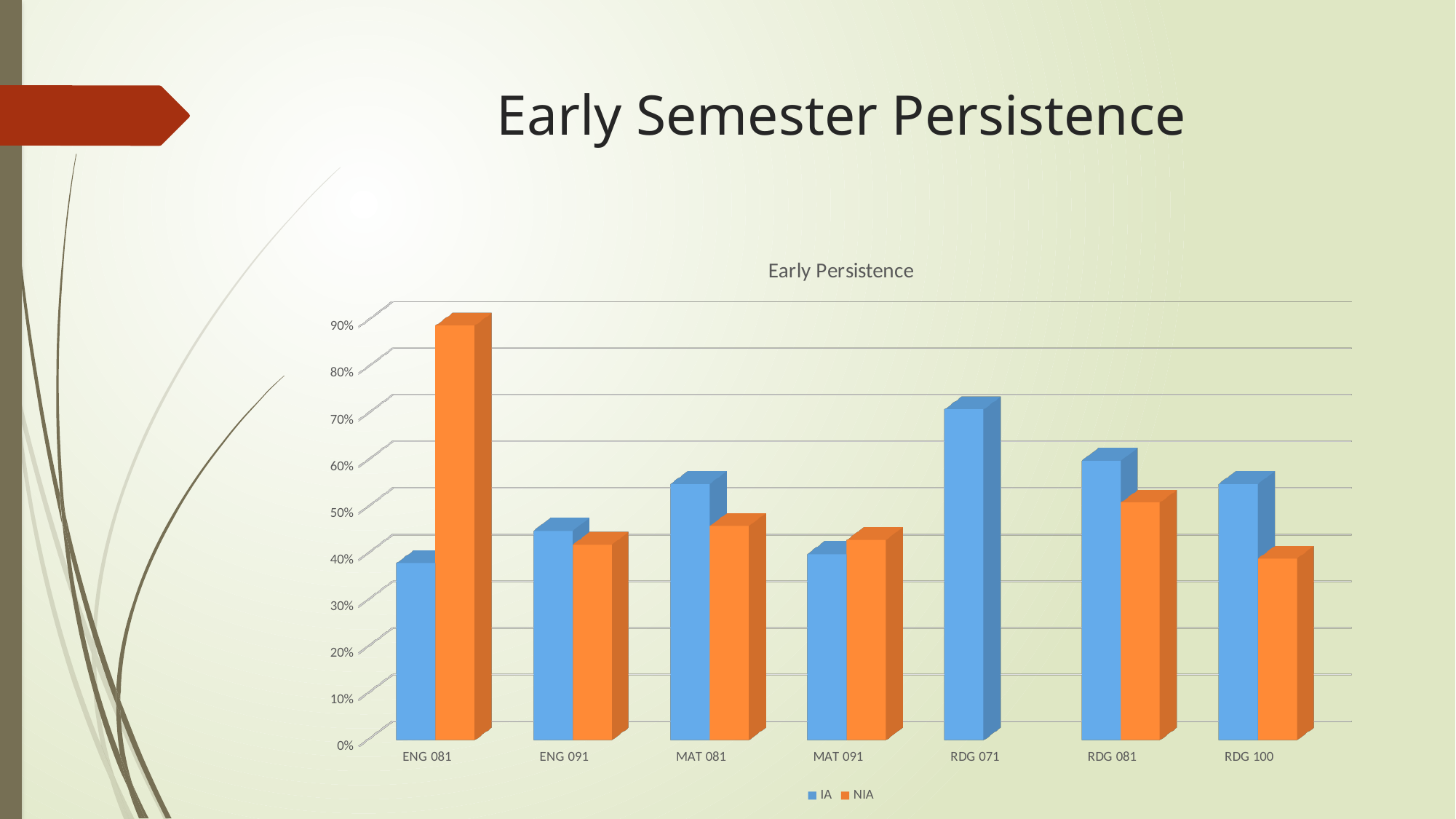
Which category has the highest NIA value? ENG 081 Is the IA value for RDG 071 greater or less than 60%? greater What kind of chart is shown on the slide? bar chart How many series does the chart's legend list? 2 Is the NIA value for ENG 081 greater or less than 80%? greater For RDG 100, which series has the larger value, IA or NIA? IA For ENG 081, which series has the larger value, IA or NIA? NIA Which category has the highest IA value? RDG 071 Is the IA value for ENG 081 greater or less than 50%? less How many course categories are shown on the x axis of the chart? 7 What is the title printed above the chart? Early Persistence